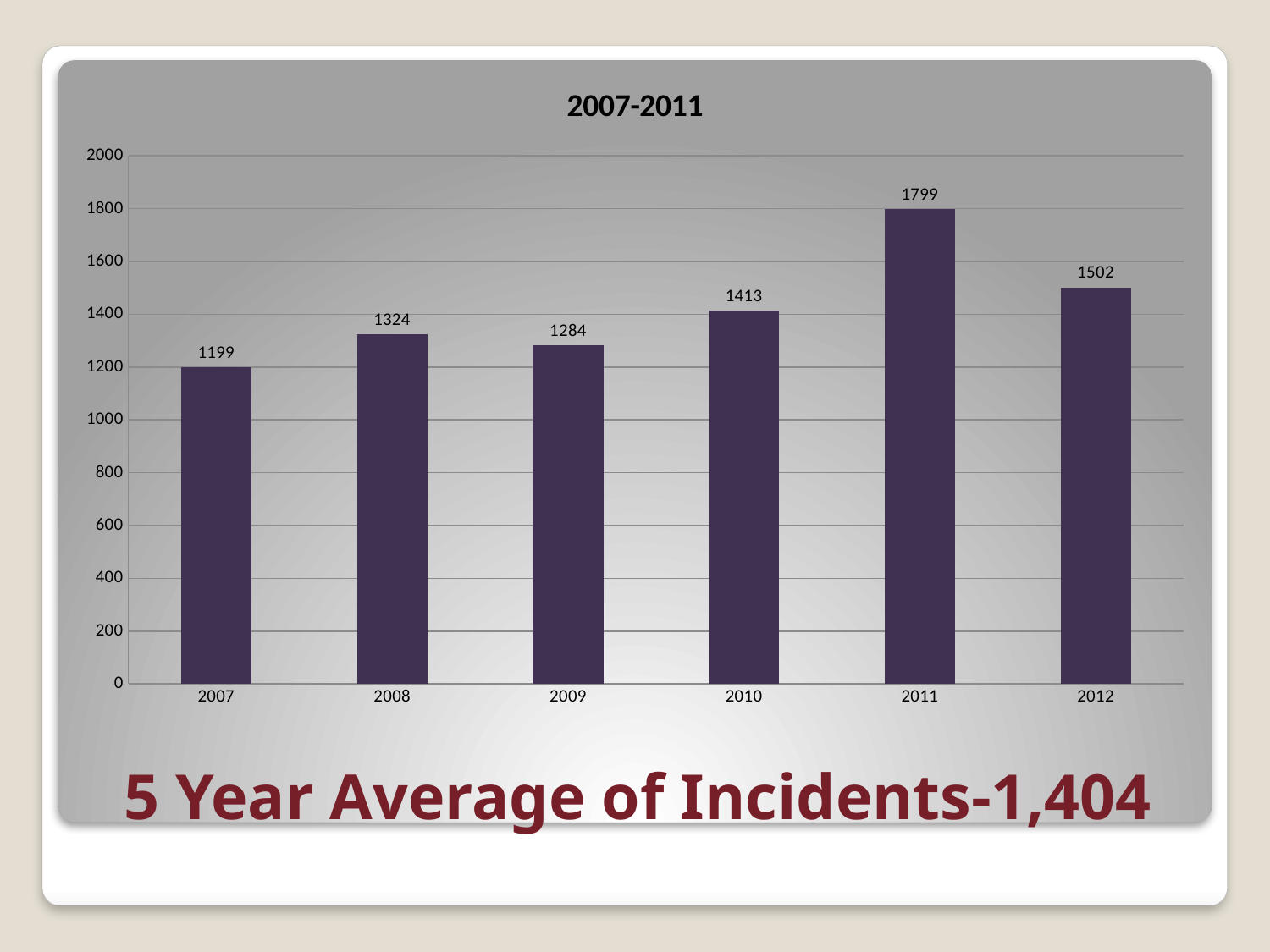
What is the value for 2010? 1413 Which is larger, the value for 2008 or the value for 2009? 2008 What is the title of the chart? 2007-2011 What is the value for 2007? 1199 What is the difference between the values for 2011 and 2012? 297 What is the value for 2012? 1502 Is the value for 2011 greater or less than 1600? greater Which year has the highest value? 2011 What is the difference between the values for 2008 and 2009? 40 What kind of chart is shown on the slide? bar chart Which year has the lowest value? 2007 How many years are shown on the x axis? 6